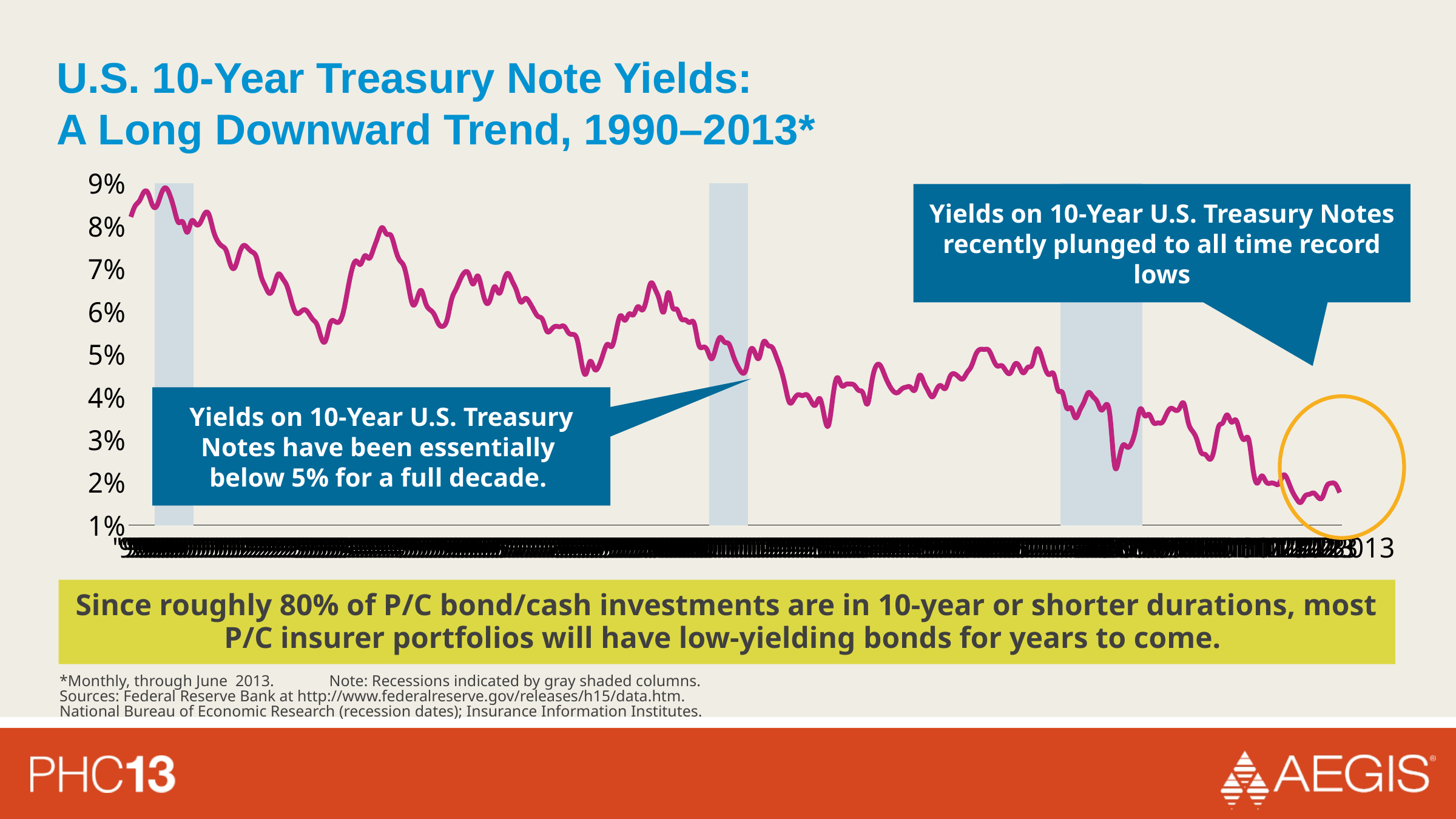
How many lines are plotted on the chart? 1 Is the yield at the end of the series (June 2013) greater or less than 3%? less What do the gray shaded columns on the chart indicate? Recessions Is the highest yield reached by the line greater or less than 8%? greater What kind of chart is shown on the slide? line chart Do the 10-year Treasury yields generally rise or fall from 1990 to 2013 along the x axis? fall Is the yield at the start of the series (1990) greater or less than 8%? greater What is the title of the chart on the slide? U.S. 10-Year Treasury Note Yields: A Long Downward Trend, 1990–2013*